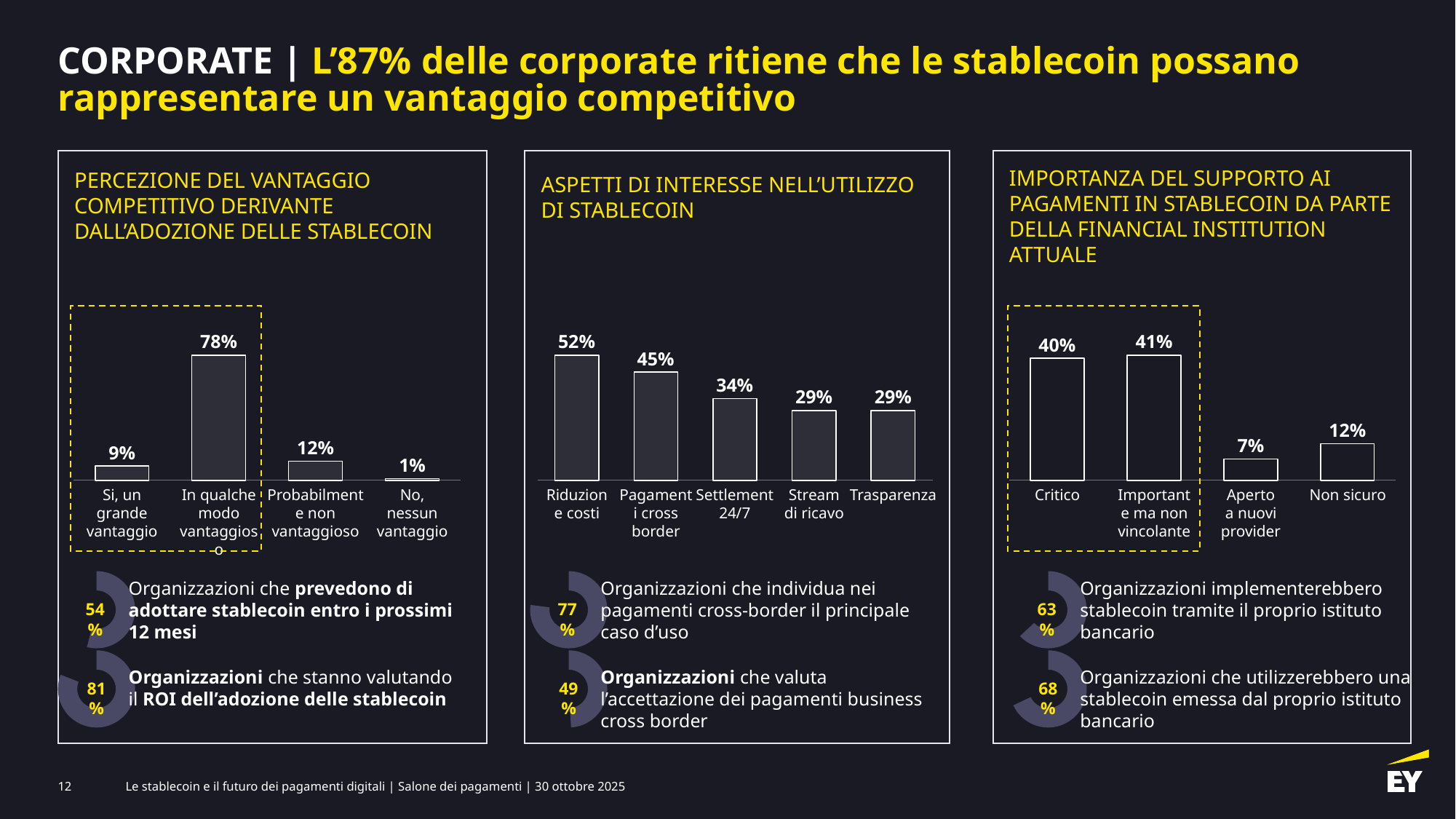
How many categories are shown in the left chart (Percezione del vantaggio competitivo)? 4 What type of chart is the middle chart (Aspetti di interesse nell'utilizzo di stablecoin)? Bar chart In the right chart (Importanza del supporto ai pagamenti in stablecoin), which category has the lowest value? Aperto a nuovi provider In the left chart (Percezione del vantaggio competitivo), which category has the lowest value? No, nessun vantaggio In the right chart (Importanza del supporto ai pagamenti in stablecoin), what is the value for 'Non sicuro'? 12% In the middle chart (Aspetti di interesse nell'utilizzo di stablecoin), which category has the highest value? Riduzione costi In the left chart (Percezione del vantaggio competitivo), what is the difference between 'Probabilmente non vantaggioso' and 'Sì, un grande vantaggio'? 3% In the right chart (Importanza del supporto ai pagamenti in stablecoin), which is larger: 'Critico' or 'Non sicuro'? Critico How many categories are shown in the middle chart (Aspetti di interesse nell'utilizzo di stablecoin)? 5 In the middle chart (Aspetti di interesse nell'utilizzo di stablecoin), what is the value for 'Settlement 24/7'? 34% In the left chart (Percezione del vantaggio competitivo), what is the value for 'In qualche modo vantaggioso'? 78% In the middle chart (Aspetti di interesse nell'utilizzo di stablecoin), what is the difference between 'Riduzione costi' and 'Pagamenti cross border'? 7%